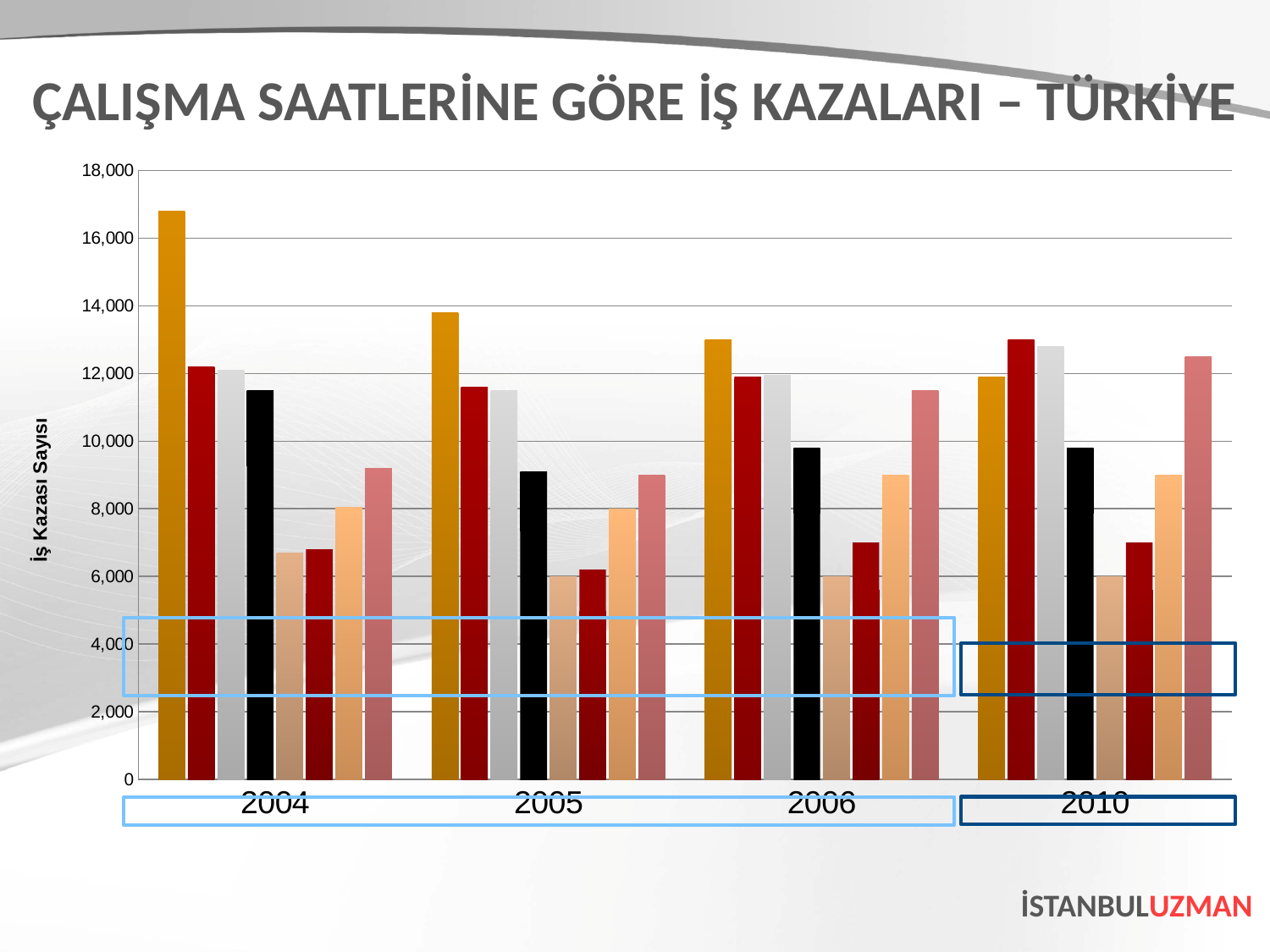
Is the value of the black bar for 2004 greater or less than 10,000? greater What is the title of the chart? ÇALIŞMA SAATLERİNE GÖRE İŞ KAZALARI – TÜRKİYE How many year categories are shown on the x axis? 4 Is the value of the last (pink) bar for 2010 greater or less than 12,000? greater Is the value of the first (orange) bar for 2004 greater or less than 16,000? greater Does the first (orange) bar rise or fall from 2004 to 2010? fall Which is larger: the first (orange) bar for 2004 or the first (orange) bar for 2005? 2004 What is the label of the vertical axis? İş Kazası Sayısı Which year has the tallest single bar in the chart? 2004 Which is larger: the black bar for 2005 or the black bar for 2004? 2004 What kind of chart is shown on the slide? bar chart